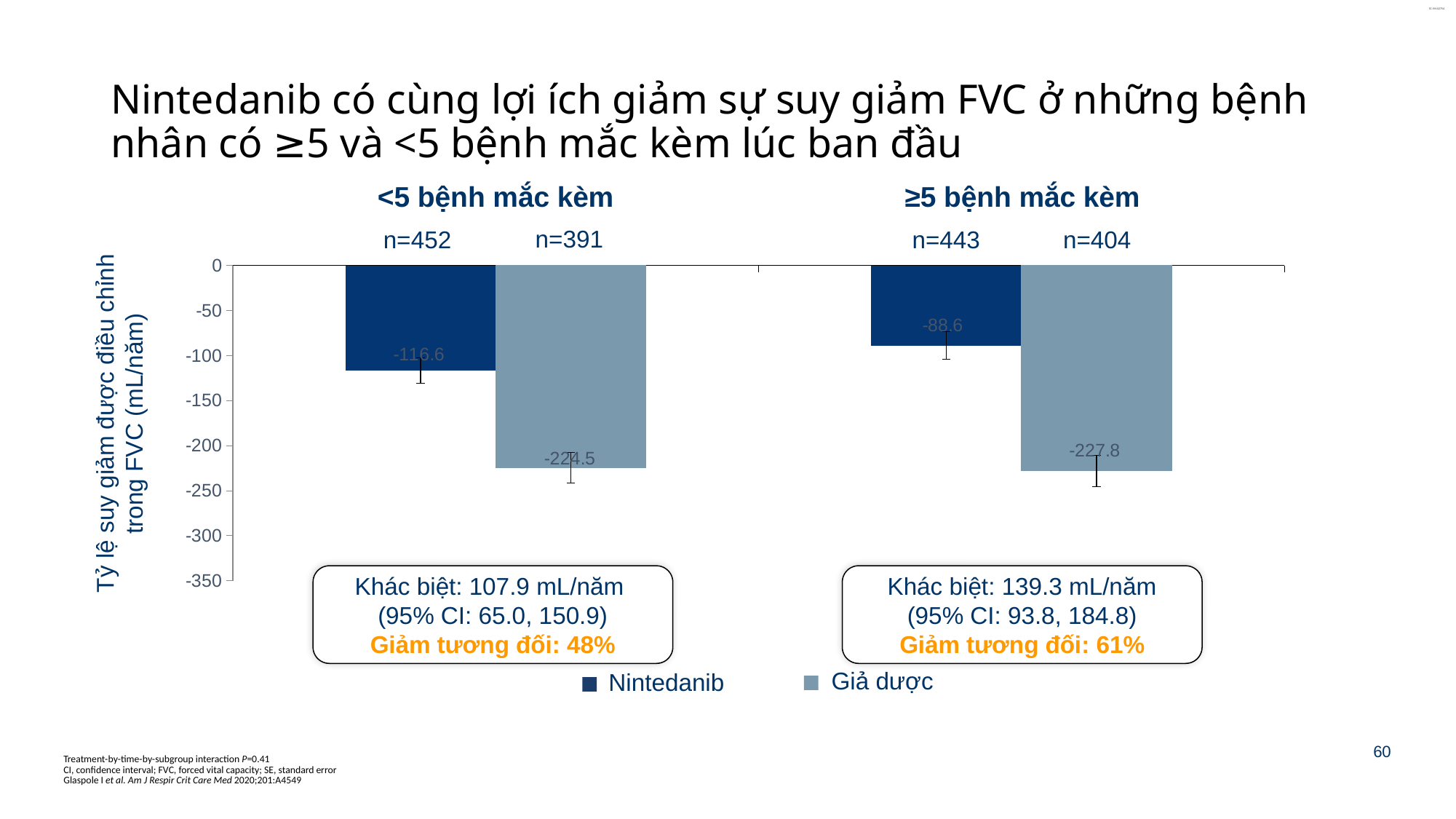
What is the value for Nintedanib in the ≥5 bệnh mắc kèm group? -88.6 What is the difference between the Giả dược and Nintedanib values in the <5 bệnh mắc kèm group? 107.9 How many series does the legend list? 2 What is the value for Giả dược in the ≥5 bệnh mắc kèm group? -227.8 What is the value for Giả dược in the <5 bệnh mắc kèm group? -224.5 Which bar has the highest (least negative) value on the chart? Nintedanib, ≥5 bệnh mắc kèm Which is more negative: the Nintedanib value in the <5 bệnh mắc kèm group or in the ≥5 bệnh mắc kèm group? <5 bệnh mắc kèm What is the sample size (n) for the Giả dược group with ≥5 bệnh mắc kèm? n=404 What kind of chart is shown on the slide? Bar chart What is the difference between the Giả dược and Nintedanib values in the ≥5 bệnh mắc kèm group? 139.2 Which bar has the lowest (most negative) value on the chart? Giả dược, ≥5 bệnh mắc kèm What is the value for Nintedanib in the <5 bệnh mắc kèm group? -116.6